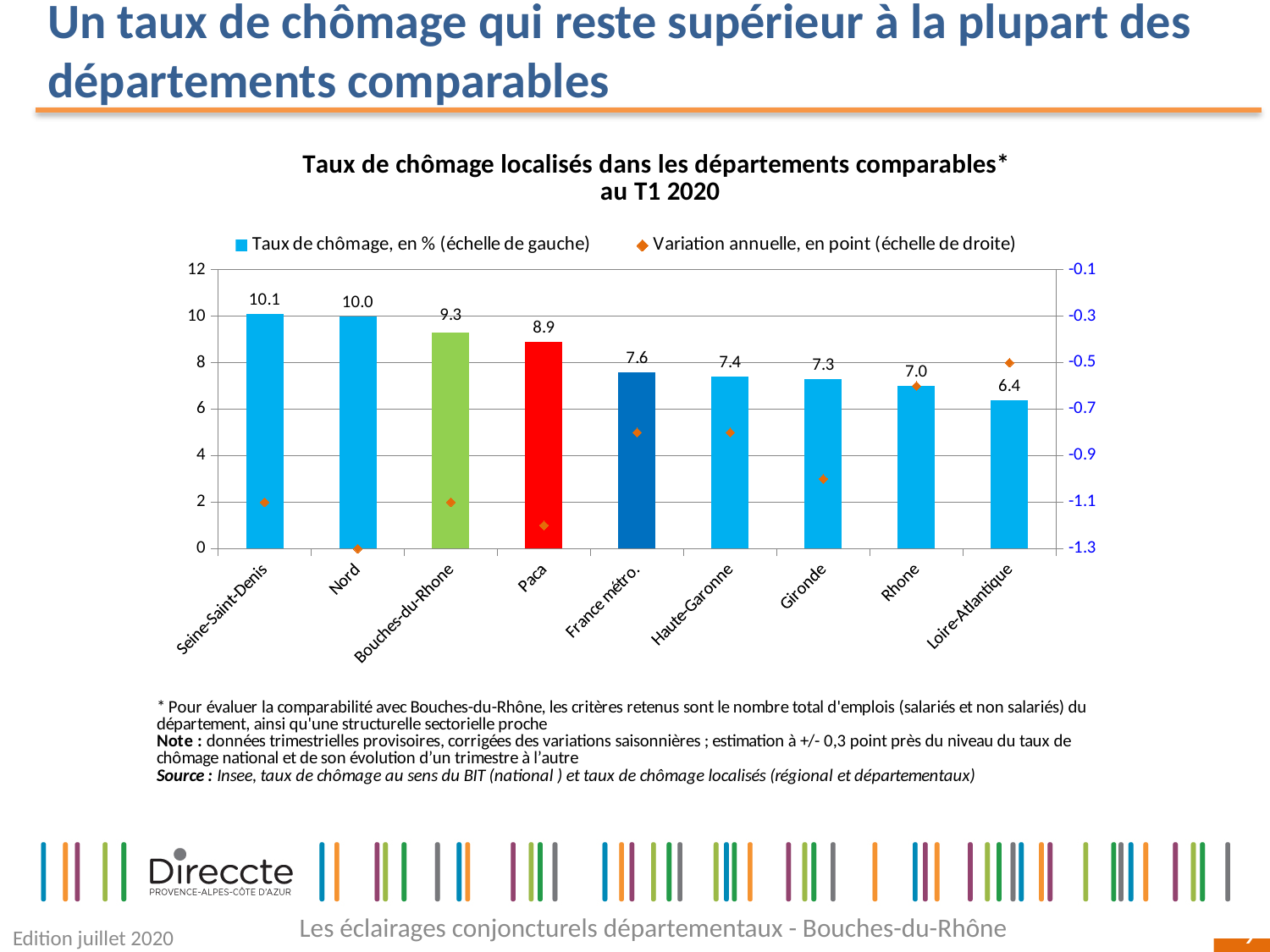
How many series does the legend list? 2 Which has a higher unemployment rate, Gironde or Rhone? Gironde What kind of chart is used to show the unemployment rate series? Bar chart What is the unemployment rate shown for France métro.? 7.6 What is the difference between the unemployment rates of Bouches-du-Rhone and Paca? 0.4 Is the annual variation (Variation annuelle) for Rhone greater or less than -0.7? greater Which category has the lowest unemployment rate bar? Loire-Atlantique What is the unemployment rate shown for Bouches-du-Rhone? 9.3 How many categories are shown on the x axis? 9 Is the annual variation (Variation annuelle) for Paca greater or less than -1.1? less What is the unemployment rate (Taux de chômage) for Seine-Saint-Denis? 10.1 Which category has the highest unemployment rate bar? Seine-Saint-Denis